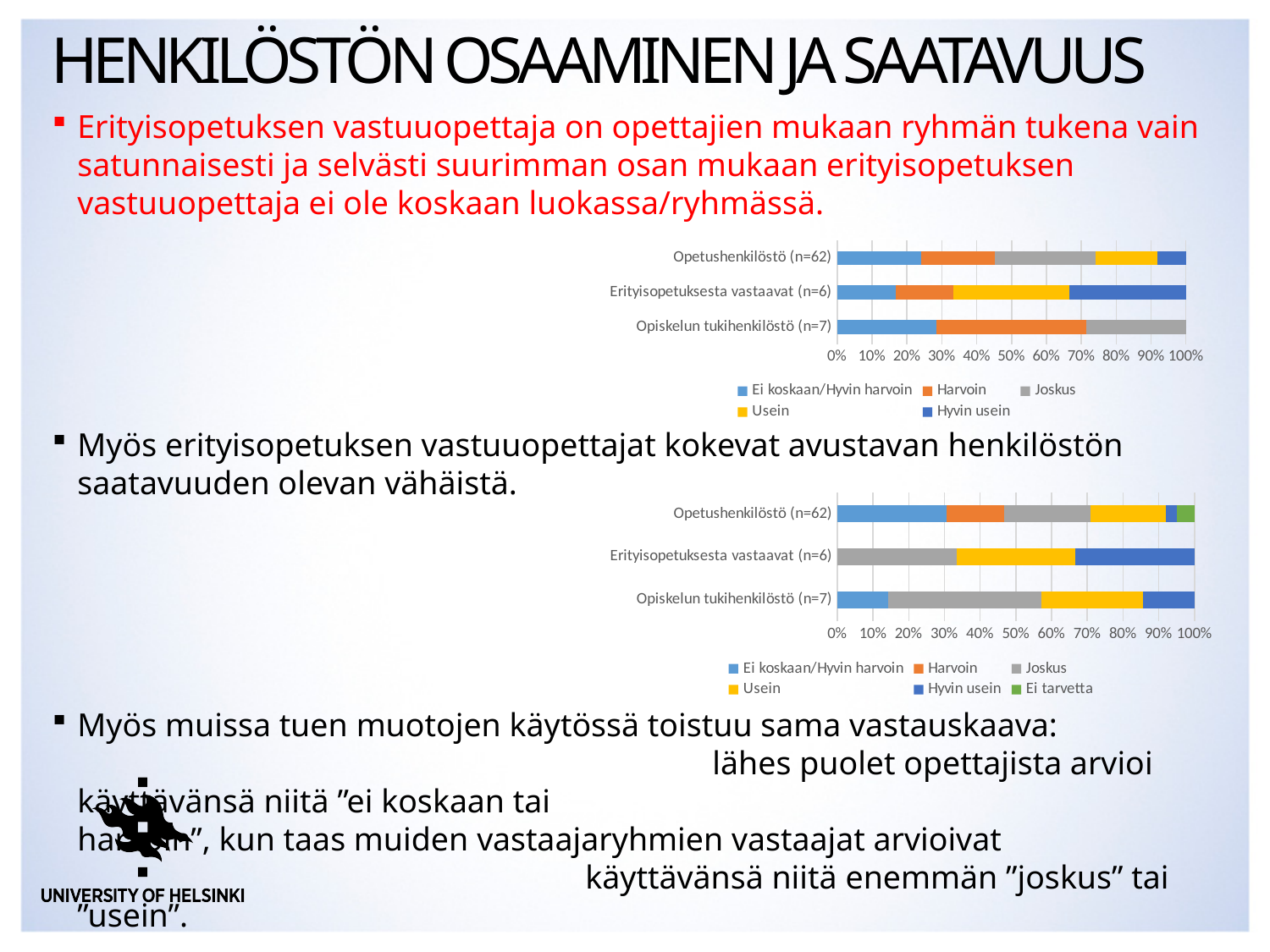
What kind of chart is the upper chart on the slide? stacked bar chart In the upper chart, is the 'Ei koskaan/Hyvin harvoin' share for Opiskelun tukihenkilöstö (n=7) greater or less than 20%? greater How many categories (respondent groups) does the upper chart show? 3 How many series does the legend of the upper chart list? 5 In the upper chart, for Opiskelun tukihenkilöstö (n=7), which is larger: the 'Harvoin' share or the 'Ei koskaan/Hyvin harvoin' share? Harvoin In the upper chart, is the 'Hyvin usein' share for Opetushenkilöstö (n=62) greater or less than 20%? less In the upper chart, is the 'Hyvin usein' share for Erityisopetuksesta vastaavat (n=6) greater or less than 20%? greater In the lower chart, which category's bar has no 'Ei koskaan/Hyvin harvoin' segment? Erityisopetuksesta vastaavat (n=6) In the lower chart, which legend entry is not present in the upper chart's legend? Ei tarvetta How many series does the legend of the lower chart list? 6